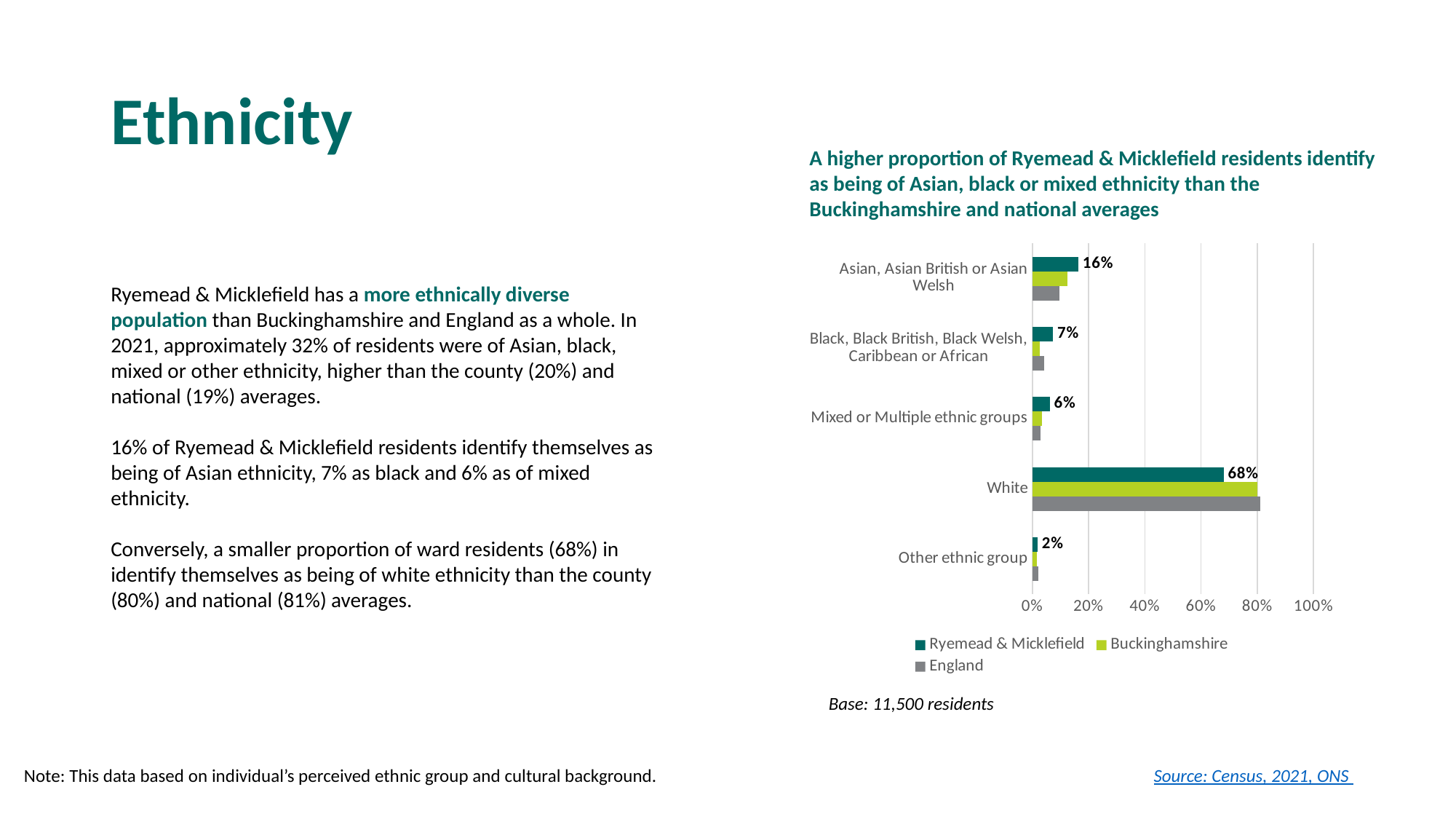
How many ethnic group categories are shown on the chart? 5 Which category has the lowest value for Ryemead & Micklefield? Other ethnic group What kind of chart is shown on the slide? Bar chart What percentage of Ryemead & Micklefield residents identify as Asian, Asian British or Asian Welsh? 16% What is the difference between the Ryemead & Micklefield values for Asian, Asian British or Asian Welsh and Black, Black British, Black Welsh, Caribbean or African? 9% How many series does the chart legend list? 3 Which category has the highest value for Ryemead & Micklefield? White What is the Ryemead & Micklefield value for Other ethnic group? 2% Which series is shown in dark teal in the chart legend? Ryemead & Micklefield Is the England value for the White category greater or less than 60%? greater What is the Ryemead & Micklefield value for the White category? 68% For Ryemead & Micklefield, which is larger: the Black, Black British, Black Welsh, Caribbean or African value or the Mixed or Multiple ethnic groups value? Black, Black British, Black Welsh, Caribbean or African